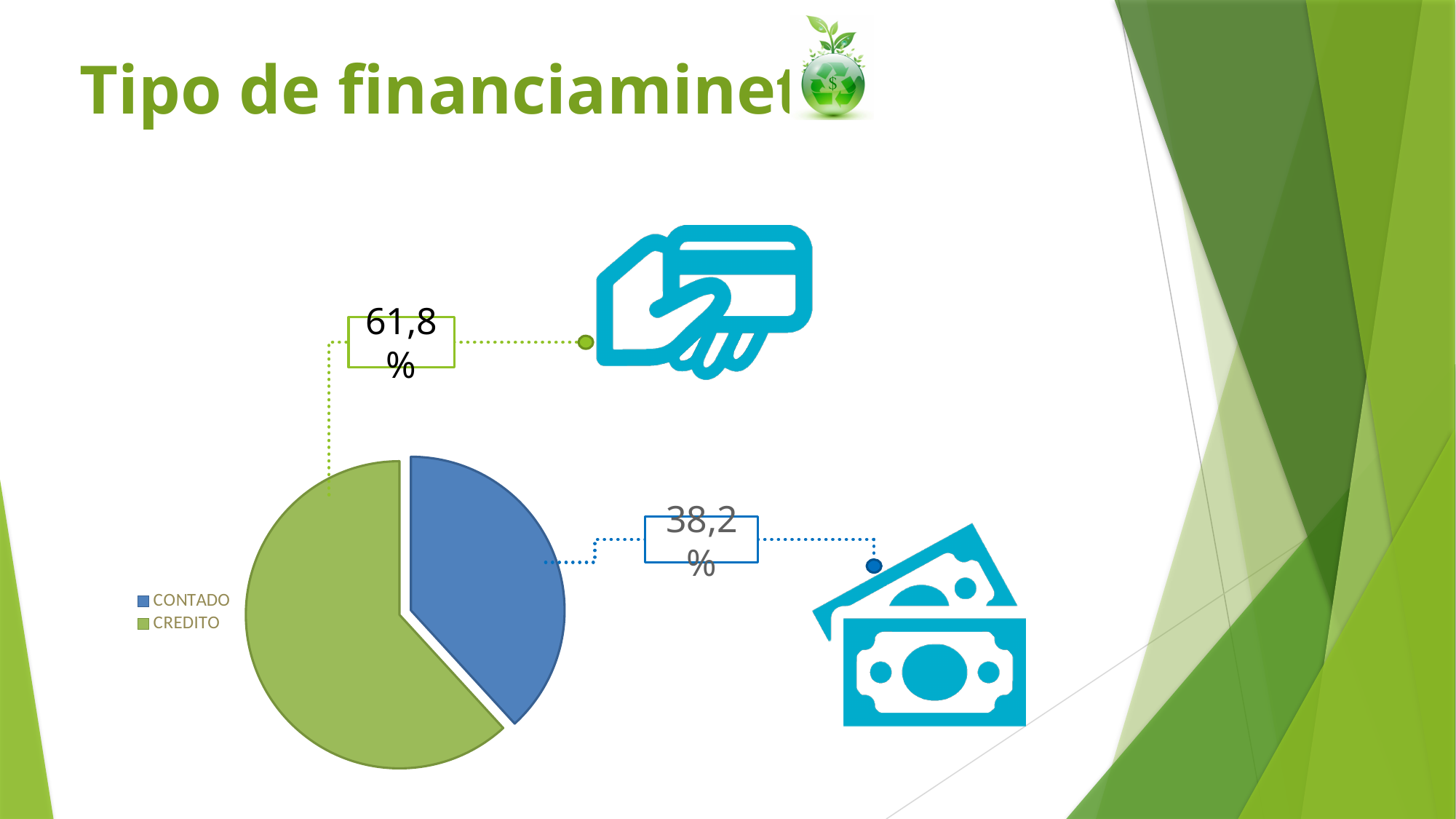
Which is larger, the CONTADO share or the CREDITO share? CREDITO Which category has the smallest share of the pie? CONTADO How many slices does the pie chart have? 2 What colour is the CONTADO slice? blue What percentage does the CONTADO slice represent? 38,2% What percentage does the CREDITO slice represent? 61,8% Which category has the largest share of the pie? CREDITO What colour is the CREDITO slice? green By how many percentage points does CREDITO exceed CONTADO? 23,6% Is the CREDITO share greater or less than 50%? greater What kind of chart is shown on the slide? pie chart How many entries does the legend list? 2